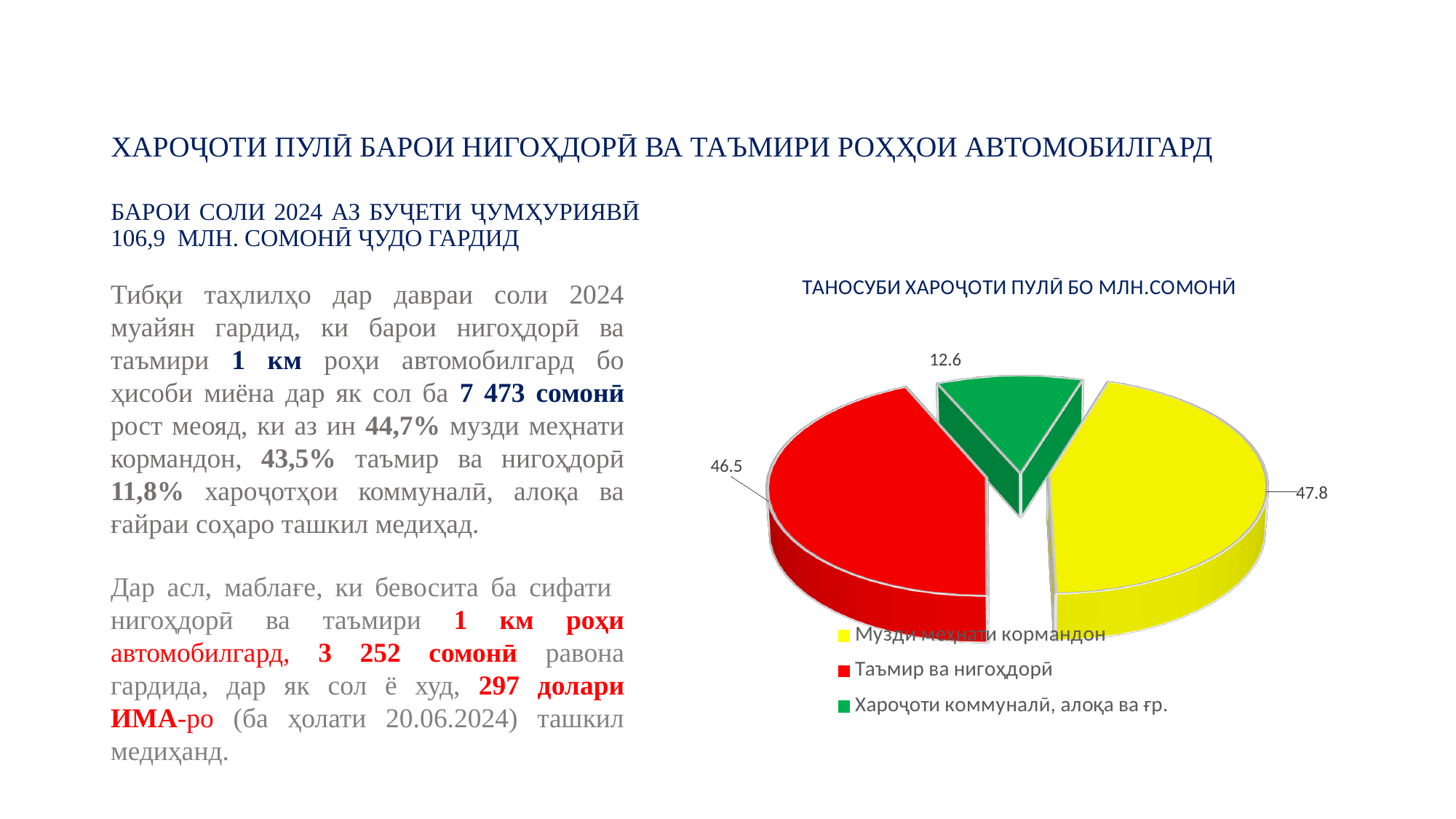
What is the value for Таъмир ва нигоҳдорӣ? 46.5 What colour is the slice for Таъмир ва нигоҳдорӣ? red Which is larger, the value for Таъмир ва нигоҳдорӣ or the value for Хароҷоти коммуналӣ, алоқа ва ғр.? Таъмир ва нигоҳдорӣ How many entries does the chart legend list? 3 What is the value for Хароҷоти коммуналӣ, алоқа ва ғр.? 12.6 What is the title of the chart? ТАНОСУБИ ХАРОҶОТИ ПУЛӢ БО МЛН.СОМОНӢ Which category has the largest slice? Музди меҳнати кормандон Which category has the smallest slice? Хароҷоти коммуналӣ, алоқа ва ғр. What is the difference between the values for Музди меҳнати кормандон and Таъмир ва нигоҳдорӣ? 1.3 How many slices does the pie chart have? 3 What is the value for Музди меҳнати кормандон? 47.8 What type of chart is shown on the slide? pie chart